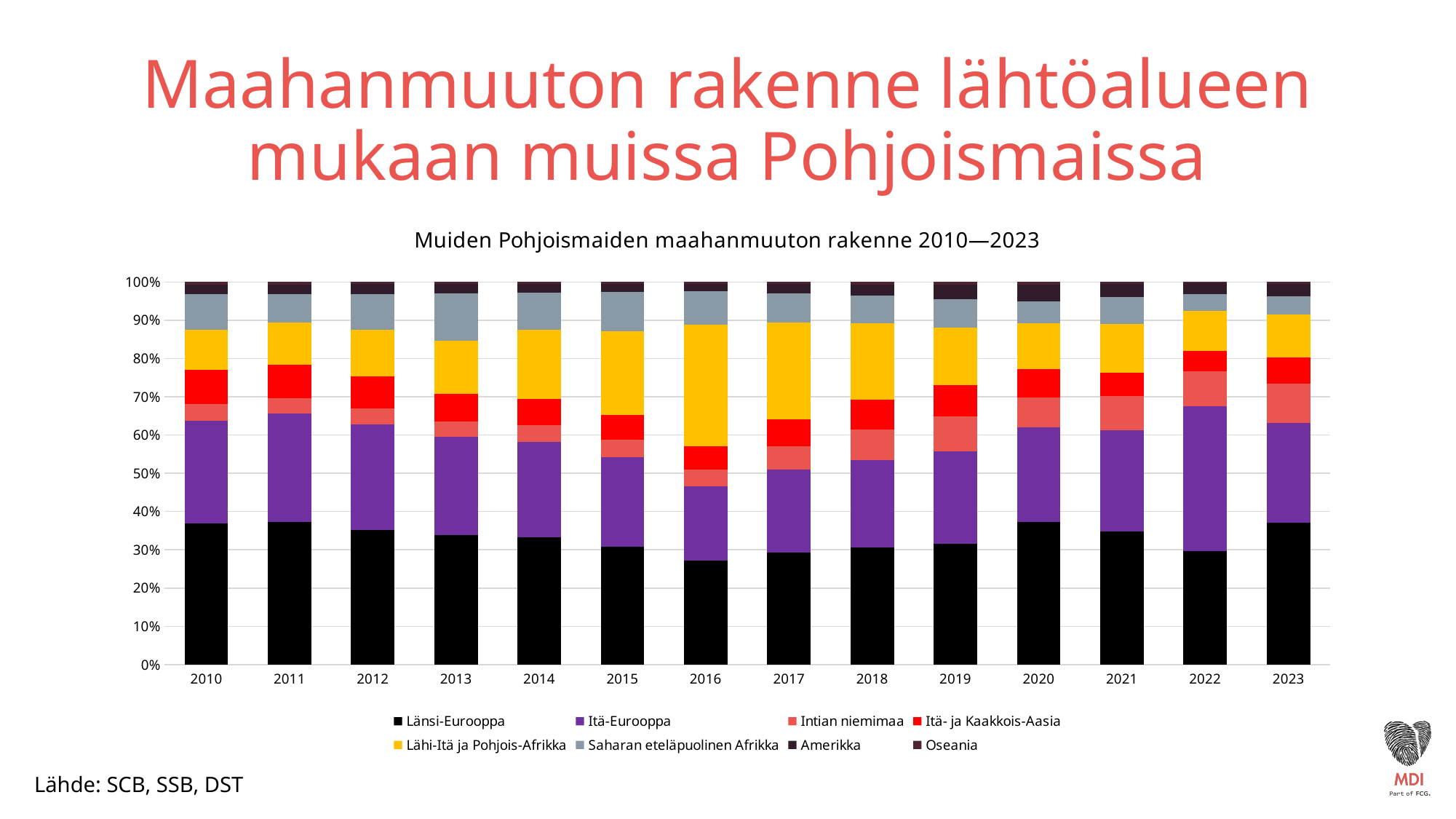
How many years are shown on the x axis of the chart? 14 Is the Länsi-Eurooppa share in 2016 greater or less than 30%? less Which series forms the bottom segment of each stacked bar? Länsi-Eurooppa Is the Länsi-Eurooppa share in 2010 greater or less than 30%? greater Which is larger, the Länsi-Eurooppa share in 2020 or in 2016? 2020 Is the Lähi-Itä ja Pohjois-Afrikka share in 2016 greater or less than 20%? greater How many series does the legend list? 8 What is the title of the chart? Muiden Pohjoismaiden maahanmuuton rakenne 2010—2023 In which year is the Lähi-Itä ja Pohjois-Afrikka segment the largest? 2016 What kind of chart is shown on the slide? Stacked bar chart Does the Länsi-Eurooppa share rise or fall from 2010 to 2016? fall